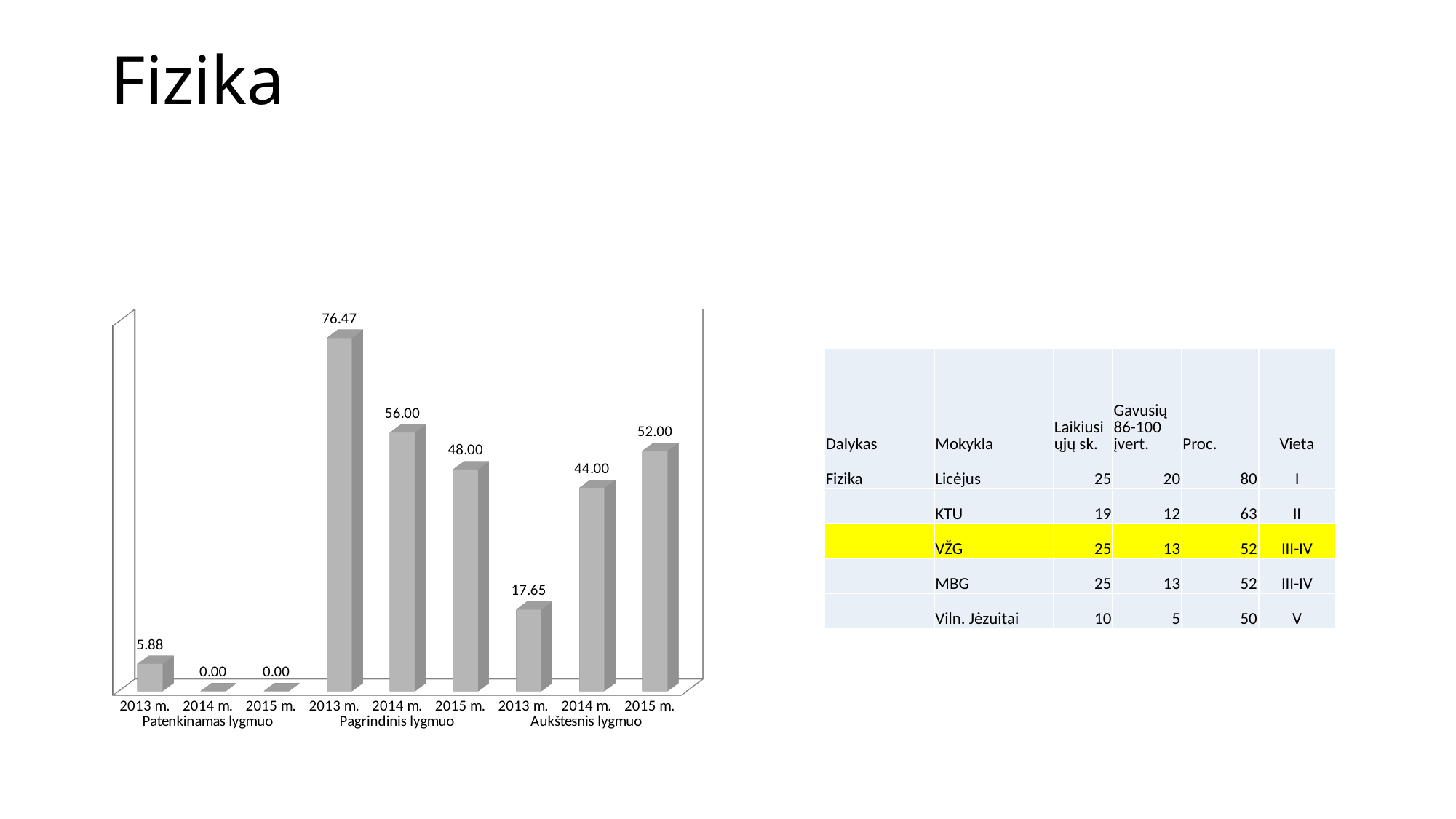
How many bars are plotted in the chart? 9 What kind of chart is shown on the slide? bar chart Do the values rise or fall from 2013 m. to 2015 m. in the Pagrindinis lygmuo group? fall What is the value for 2013 m. in the Pagrindinis lygmuo group? 76.47 Which is larger: the 2015 m. value for Pagrindinis lygmuo or the 2015 m. value for Aukštesnis lygmuo? Aukštesnis lygmuo What is the value for 2014 m. in the Aukštesnis lygmuo group? 44.00 Which year has the lowest value in the Aukštesnis lygmuo group? 2013 m. Which bar has the highest value in the chart? 2013 m. Pagrindinis lygmuo Do the values rise or fall from 2013 m. to 2015 m. in the Aukštesnis lygmuo group? rise What is the value for 2013 m. in the Patenkinamas lygmuo group? 5.88 What is the value for 2015 m. in the Aukštesnis lygmuo group? 52.00 What is the difference between the 2014 m. and 2015 m. values in the Pagrindinis lygmuo group? 8.00